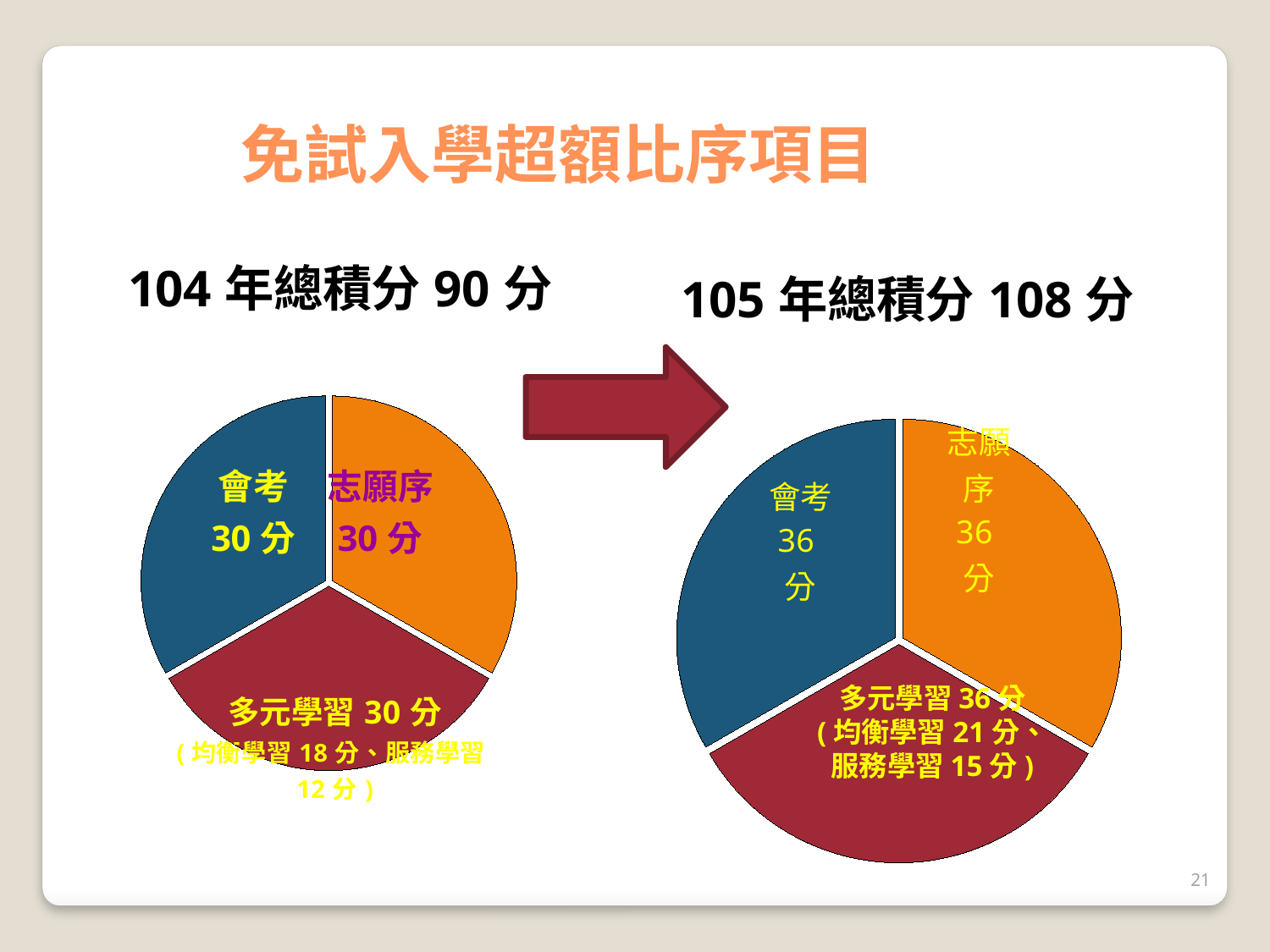
In the left pie chart (104 年總積分 90 分), what is the value for 志願序? 30 分 In the right pie chart (105 年總積分 108 分), what colour is the 志願序 slice? Orange In the left pie chart (104 年總積分 90 分), what is the value for 會考? 30 分 In the right pie chart (105 年總積分 108 分), how many points does 服務學習 contribute within 多元學習? 15 分 What kind of chart is used for 105 年總積分 108 分 on the right? Pie chart How many slices does the left pie chart (104 年總積分 90 分) have? 3 In the left pie chart (104 年總積分 90 分), what is the difference between 均衡學習 and 服務學習? 6 分 What is the difference between the 會考 value in the right chart (105 年) and the 會考 value in the left chart (104 年)? 6 分 What is the total score shown for the right pie chart (105 年)? 108 分 In the left pie chart (104 年總積分 90 分), how many points does 服務學習 contribute within 多元學習? 12 分 In the right pie chart (105 年總積分 108 分), how many points does 均衡學習 contribute within 多元學習? 21 分 In the right pie chart (105 年總積分 108 分), what is the value for 多元學習? 36 分